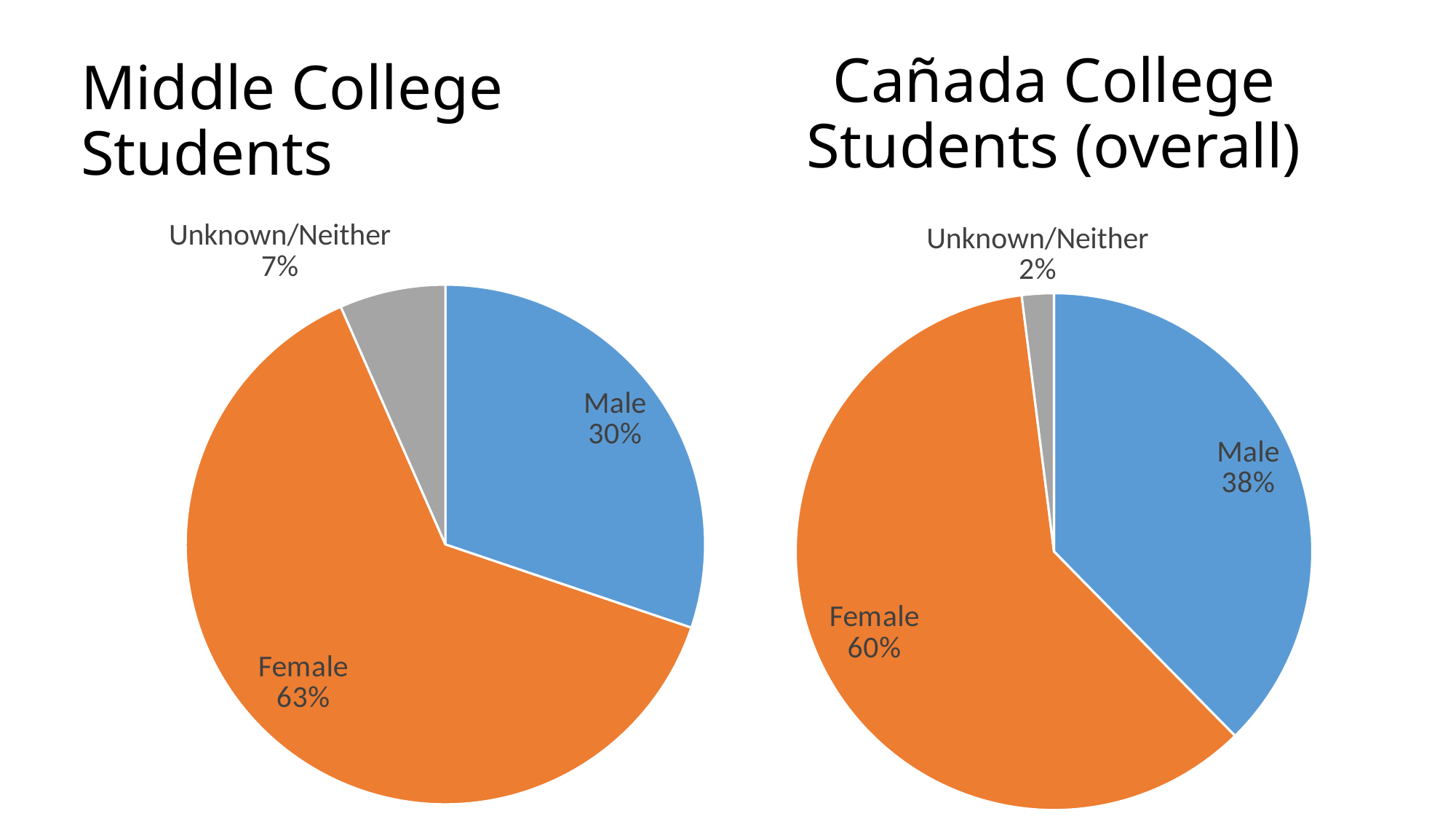
In the Middle College Students chart, what is the difference between the Female and Male percentages? 33% In the Middle College Students chart, what percentage of students are Male? 30% In the Middle College Students chart, what share of students are Female? 63% In the Cañada College Students (overall) chart, what share of students are Male? 38% In the Cañada College Students (overall) chart, what percentage is Unknown/Neither? 2% In the Cañada College Students (overall) chart, what is the difference between the Female and Male percentages? 22% In the Cañada College Students (overall) chart, which category has the smallest slice? Unknown/Neither What type of chart is used for Cañada College Students (overall)? Pie chart In the Middle College Students chart, what colour is the Unknown/Neither slice? Grey How many categories does the Middle College Students pie chart show? 3 Which chart has the larger Male share, Middle College Students or Cañada College Students (overall)? Cañada College Students (overall) In the Middle College Students chart, which category has the largest slice? Female